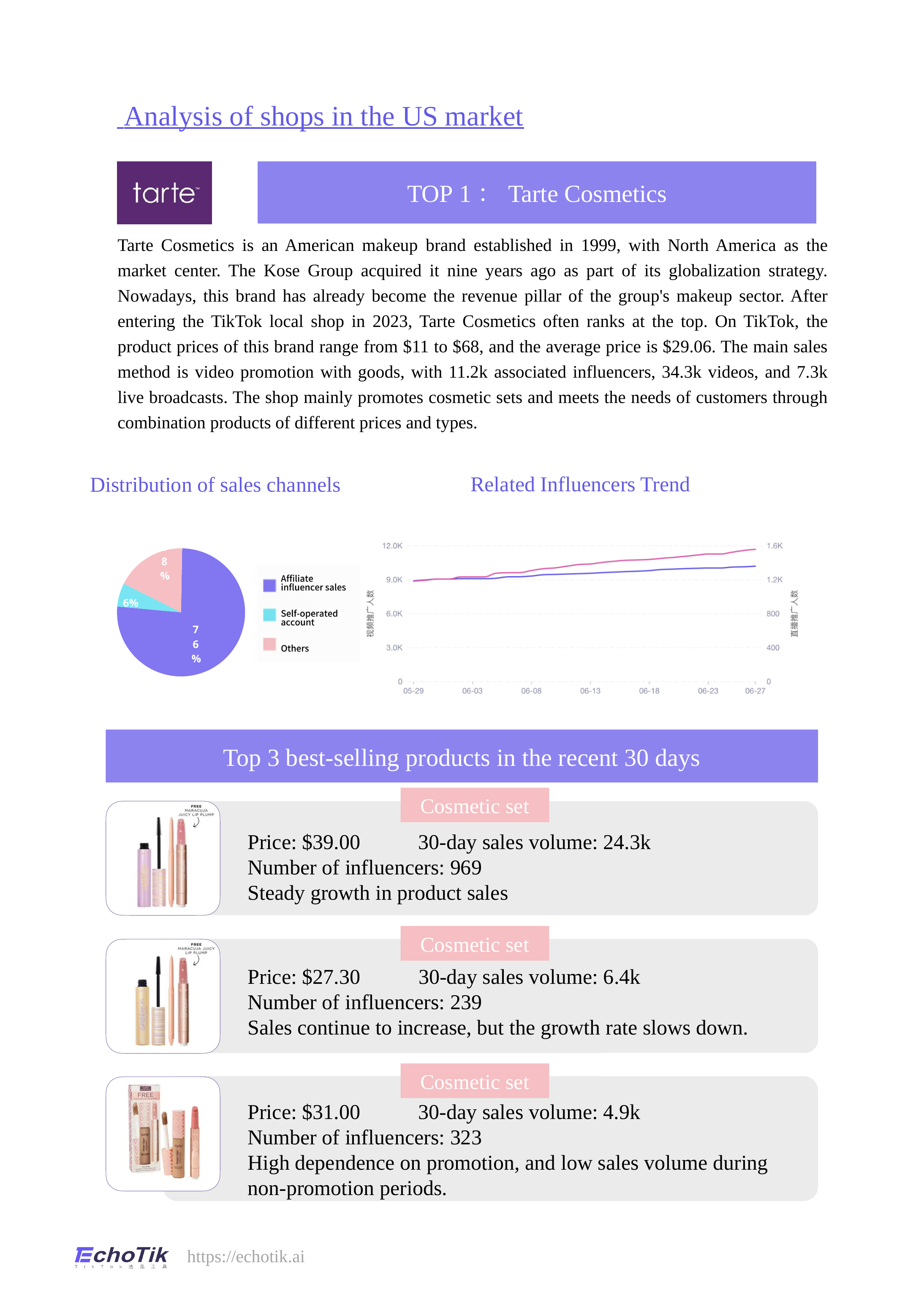
In the 'Distribution of sales channels' chart, which sales channel has the smallest share? Self-operated account What kind of chart is 'Distribution of sales channels'? Pie chart What kind of chart is 'Related Influencers Trend'? Line chart In the 'Distribution of sales channels' chart, which sales channel has the largest share? Affiliate influencer sales In the 'Distribution of sales channels' chart, what share of sales comes from Affiliate influencer sales? 76% In the 'Related Influencers Trend' chart, do the lines generally rise or fall from 05-29 to 06-27? Rise In the 'Distribution of sales channels' chart, what share of sales comes from the Self-operated account? 6% In the 'Related Influencers Trend' chart, what is the highest value shown on the left vertical axis? 12.0K How many categories does the 'Distribution of sales channels' chart show? 3 In the 'Distribution of sales channels' chart, which is larger: the share for Others or the share for Self-operated account? Others